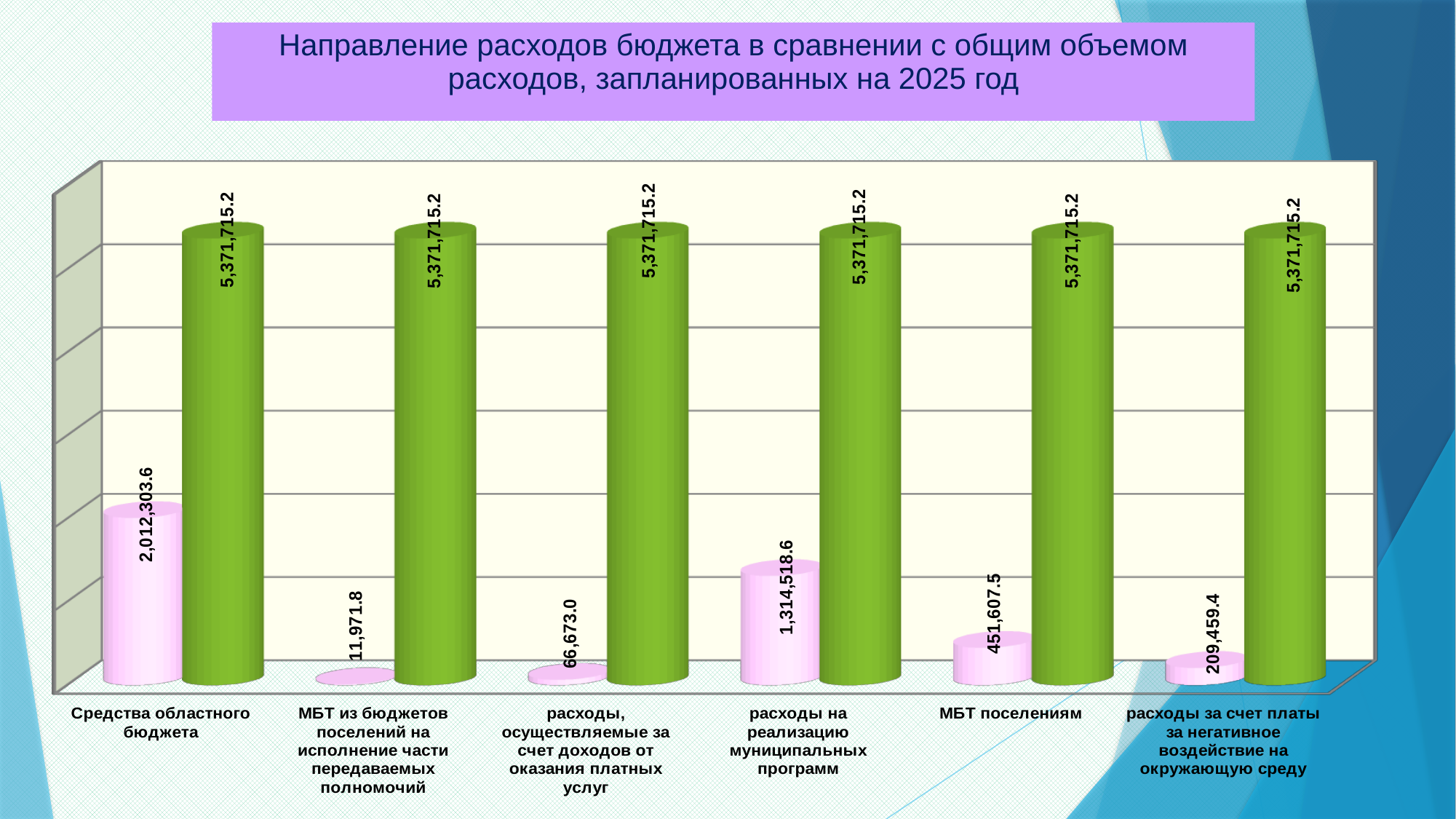
What is the title of the slide? Направление расходов бюджета в сравнении с общим объемом расходов, запланированных на 2025 год Which category has the lowest pink bar? МБТ из бюджетов поселений на исполнение части передаваемых полномочий Which category has the highest pink bar? Средства областного бюджета What is the value of the pink bar for "МБТ из бюджетов поселений на исполнение части передаваемых полномочий"? 11,971.8 What is the difference between the pink bar values for "Средства областного бюджета" and "расходы на реализацию муниципальных программ"? 697,785.0 Which pink bar is larger: "МБТ поселениям" or "расходы за счет платы за негативное воздействие на окружающую среду"? МБТ поселениям How many categories are shown on the x axis? 6 What is the value of the pink bar for "расходы на реализацию муниципальных программ"? 1,314,518.6 What is the value of the pink bar for "МБТ поселениям"? 451,607.5 What kind of chart is shown on the slide? Bar chart What is the value of the pink bar for "Средства областного бюджета"? 2,012,303.6 What value is shown on each green bar? 5,371,715.2